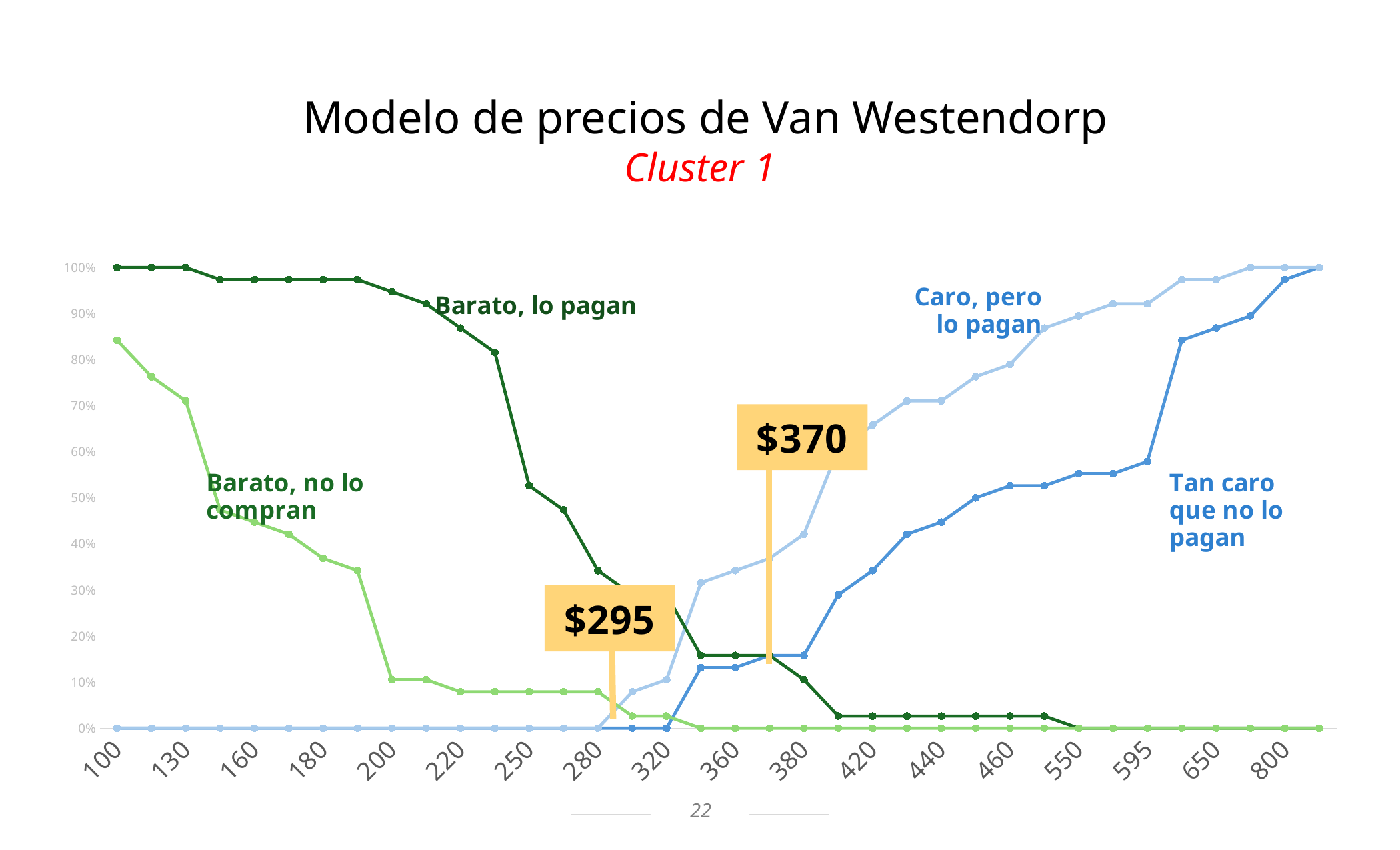
What is the value of the 'Barato, lo pagan' series at a price of 100? 100% How many labelled series are plotted on the chart? 4 At a price of 460, which series has the higher value: 'Caro, pero lo pagan' or 'Tan caro que no lo pagan'? Caro, pero lo pagan What kind of chart is shown on the slide? line chart Is the value of 'Barato, lo pagan' at a price of 220 greater or less than 80%? greater Is the value of 'Barato, no lo compran' at a price of 100 greater or less than 80%? greater Which cluster does the subtitle say the chart refers to? Cluster 1 What is the value of the 'Tan caro que no lo pagan' series at a price of 100? 0% What is the title of the chart on the slide? Modelo de precios de Van Westendorp Does the 'Barato, no lo compran' series rise or fall as price increases along the x axis? falls Is the value of 'Tan caro que no lo pagan' at a price of 595 greater or less than 70%? less Does the 'Caro, pero lo pagan' series rise or fall as price increases along the x axis? rises